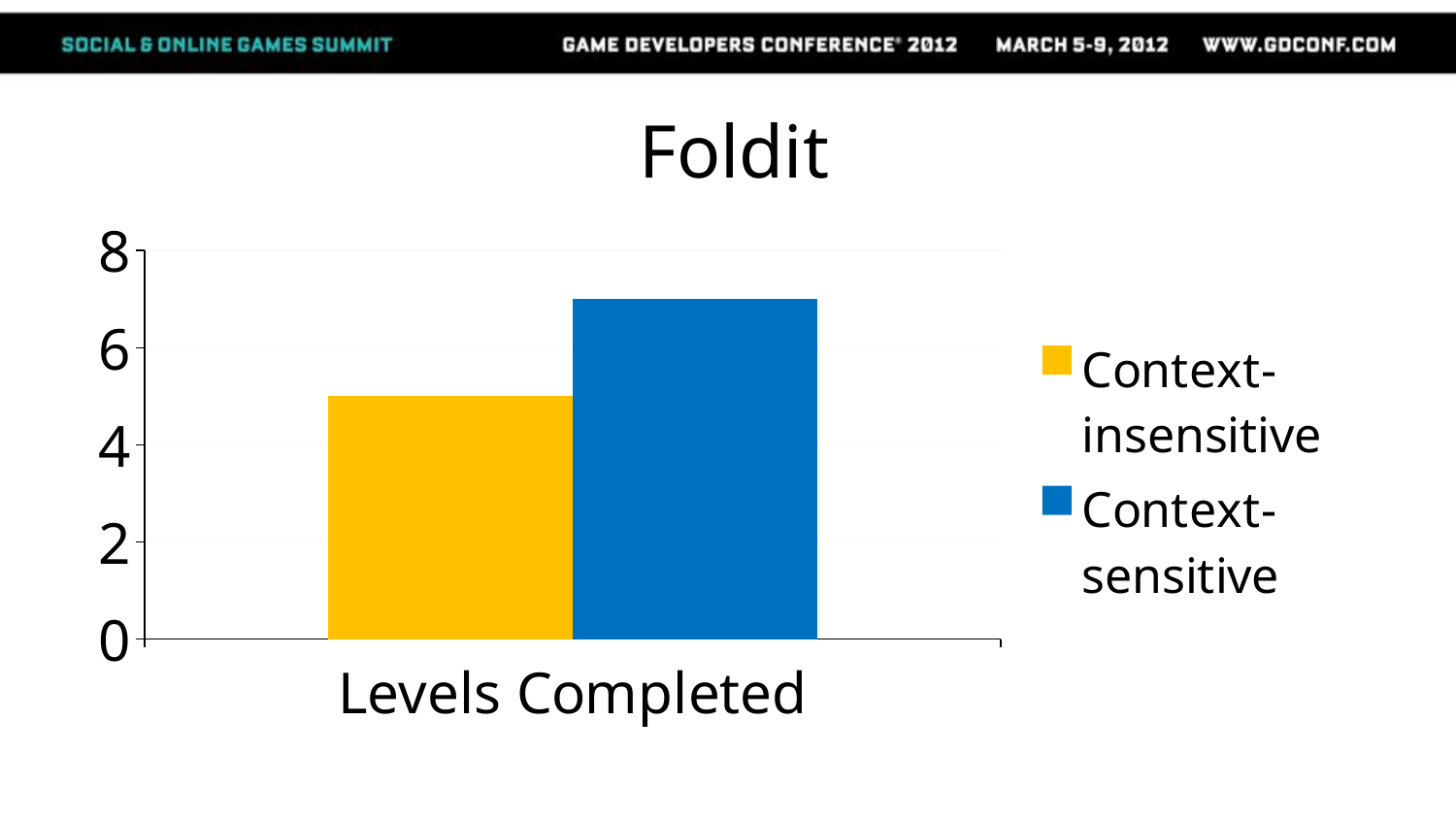
Is the value for Context-sensitive greater or less than 8? less Is the value for Context-sensitive greater or less than 6? greater Is the value for Context-insensitive greater or less than 4? greater Which series has the lower value for Levels Completed? Context-insensitive Which series has the higher value for Levels Completed? Context-sensitive What is the title of the chart? Foldit How many categories are shown on the x axis? 1 Is the Context-sensitive bar larger or smaller than the Context-insensitive bar? larger What kind of chart is shown on the slide? bar chart How many series does the legend list? 2 What is the category label on the x axis? Levels Completed